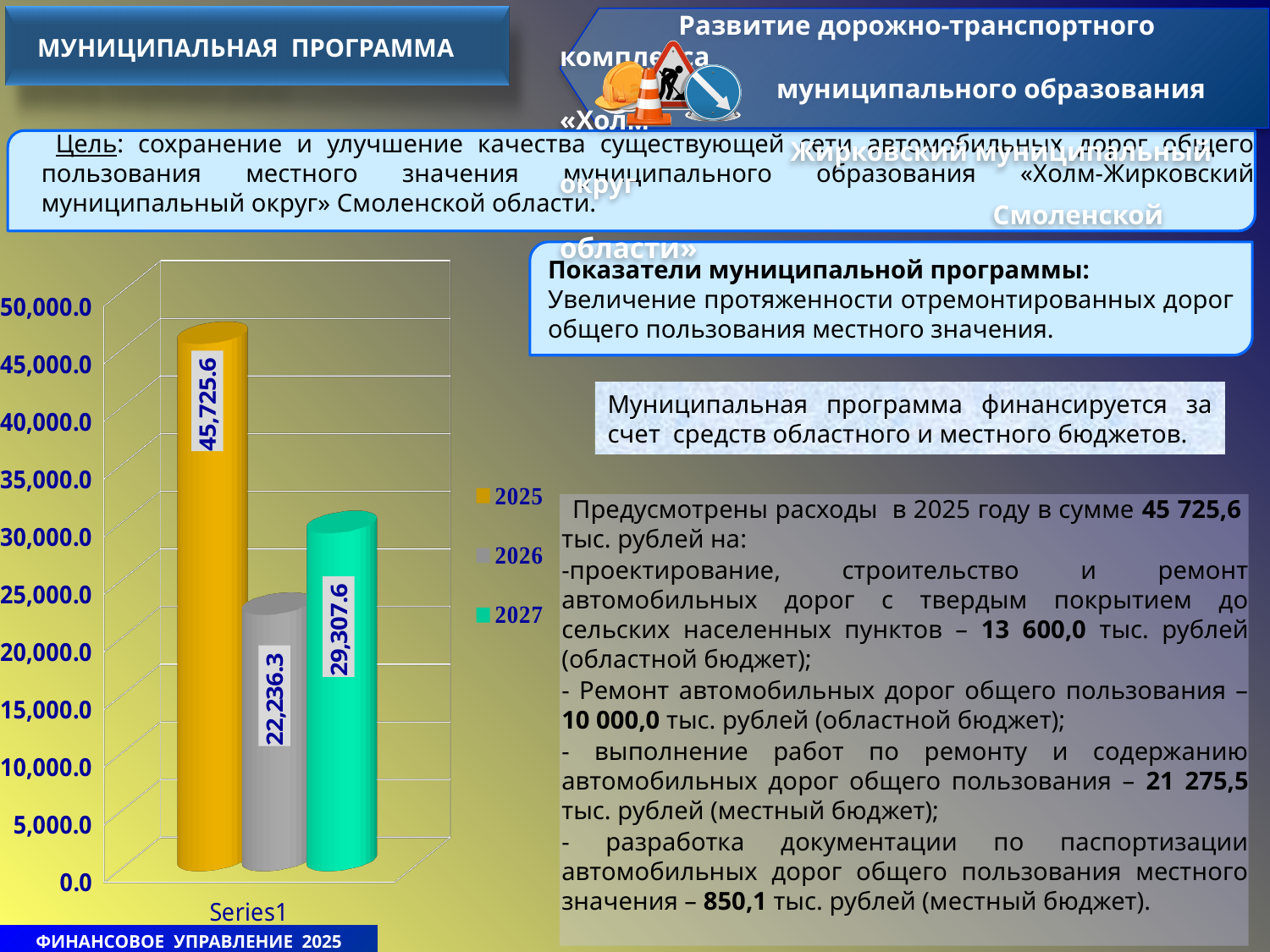
What kind of chart is shown on the slide? bar chart What colour is the bar for 2027 in the chart? green Which year has the lowest value on the chart? 2026 Which year has the highest value on the chart? 2025 How many series does the chart legend list? 3 What is the value shown for 2025 on the chart? 45,725.6 What is the difference between the values for 2027 and 2026? 7,071.3 Is the value for 2025 greater or less than 40,000.0? greater What is the value shown for 2026 on the chart? 22,236.3 Which is larger, the value for 2026 or the value for 2027? 2027 What is the difference between the values for 2025 and 2026? 23,489.3 What is the value shown for 2027 on the chart? 29,307.6